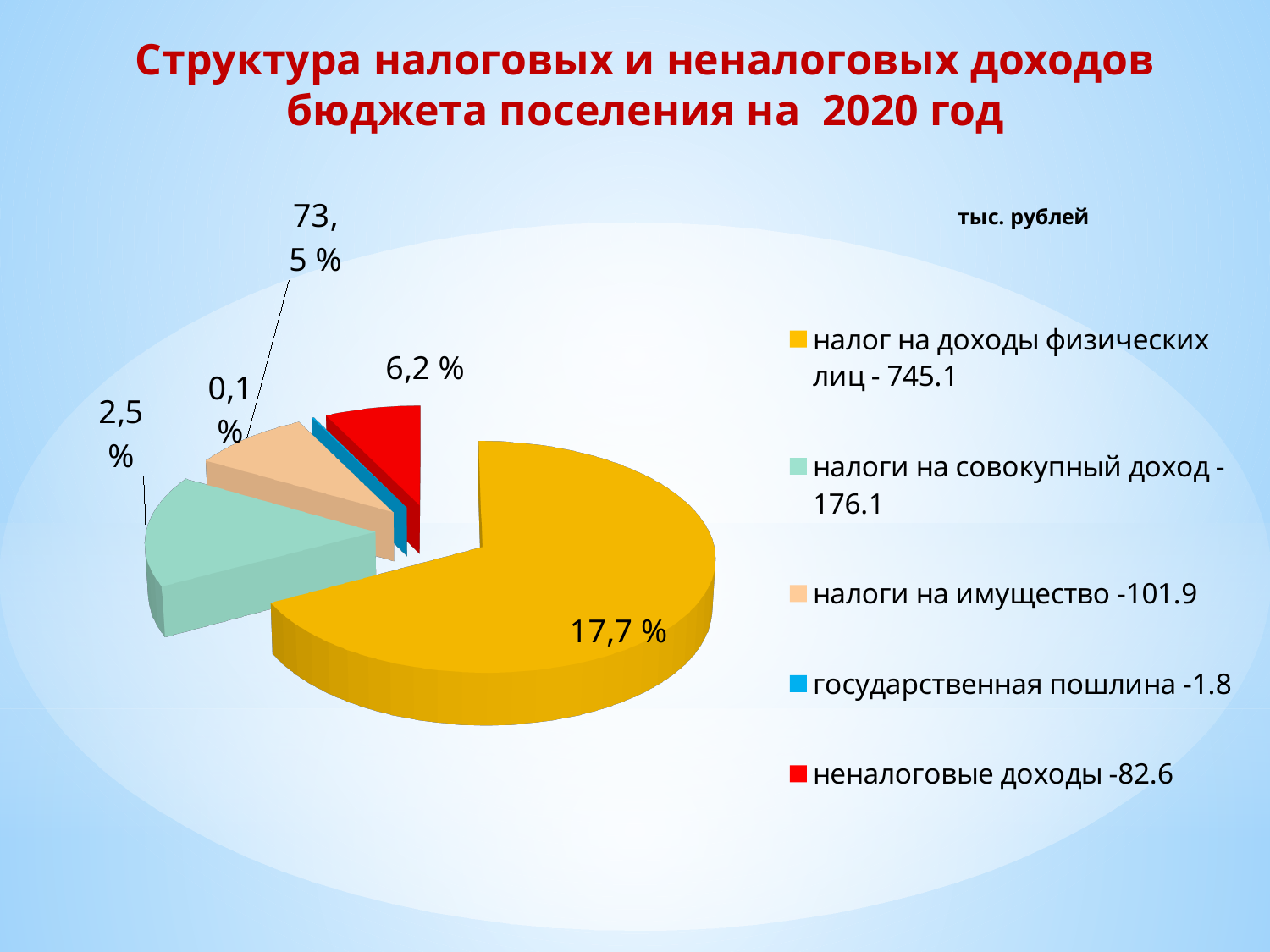
Which category has the largest value in the pie chart? налог на доходы физических лиц In what units are the values in the chart given, according to the note above the legend? тыс. рублей Which is larger: налоги на имущество or неналоговые доходы? налоги на имущество What kind of chart is shown on the slide? pie chart What value is given in the legend for неналоговые доходы? 82.6 What is the difference between the values for налоги на совокупный доход and налоги на имущество? 74.2 What value is given in the legend for налоги на совокупный доход? 176.1 What value is given in the legend for государственная пошлина? 1.8 What value is given in the legend for налоги на имущество? 101.9 How many categories does the legend of the pie chart list? 5 Which category has the smallest value in the pie chart? государственная пошлина What value is given in the legend for налог на доходы физических лиц? 745.1